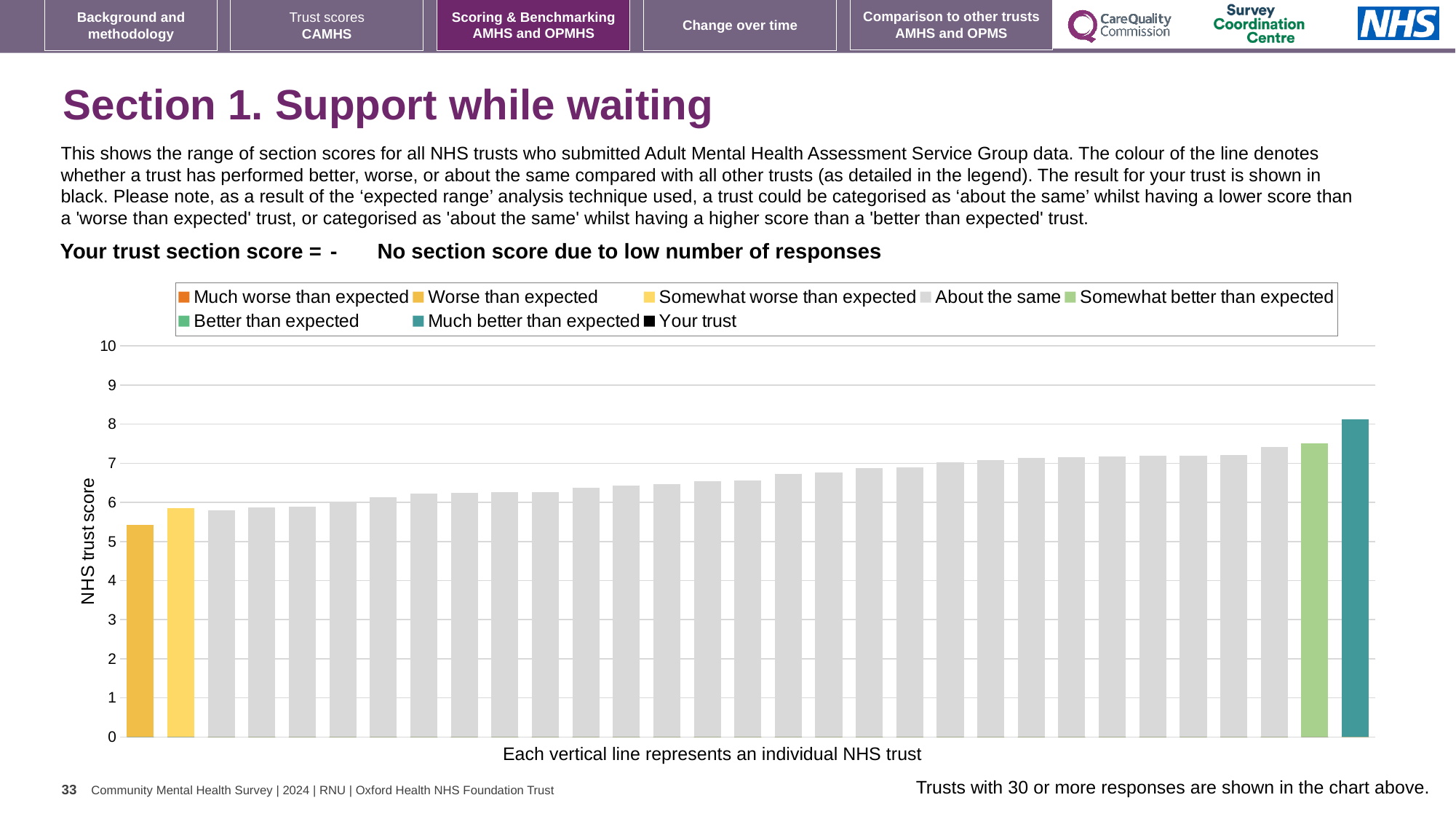
Is the value of the second bar from the left greater or less than 6? less Which legend category does the shortest bar belong to? Worse than expected Which legend category does the tallest bar belong to? Much better than expected What is the label on the vertical axis of the chart? NHS trust score Is the value of the shortest bar greater or less than 5? greater Is the value of the tallest bar greater or less than 7? greater How many entries does the chart legend list? 8 What does the text below the x axis say each vertical line represents? an individual NHS trust Do the bar values rise or fall from left to right along the x axis? rise What kind of chart is shown on the slide? bar chart